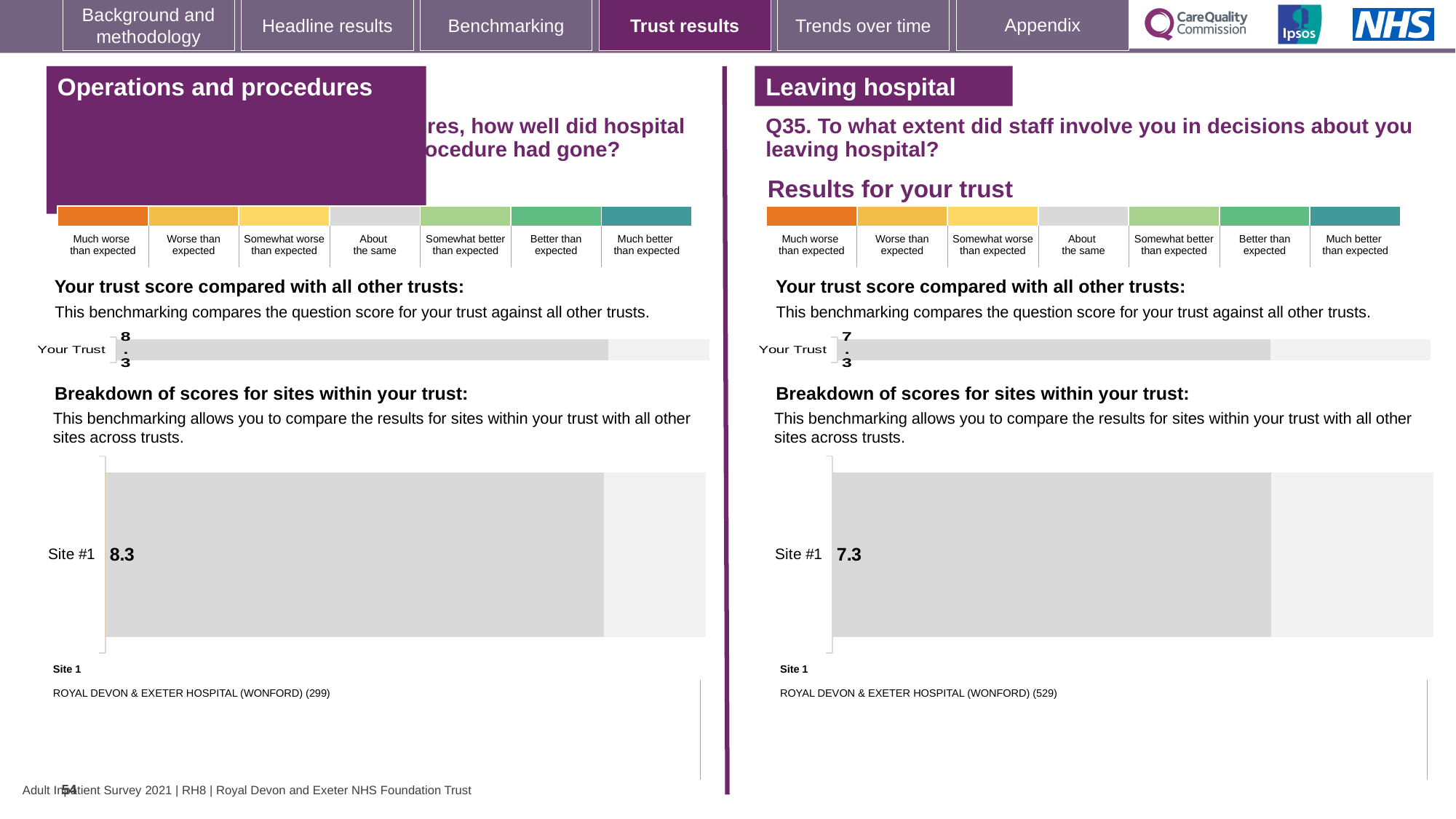
What type of chart is used to show the Your Trust score in the 'Operations and procedures' section? Bar chart What is the difference between the Site #1 score in the 'Operations and procedures' section and the Site #1 score in the 'Leaving hospital' section? 1.0 How many sites are shown in the 'Breakdown of scores for sites within your trust' chart in the 'Leaving hospital' section? 1 How many sites are shown in the 'Breakdown of scores for sites within your trust' chart in the 'Operations and procedures' section? 1 Which site is listed as Site 1 in the 'Leaving hospital' section? ROYAL DEVON & EXETER HOSPITAL (WONFORD) (529) In the 'Leaving hospital' section, what score is shown for Site #1 in the 'Breakdown of scores for sites within your trust' chart? 7.3 Which is larger: the Your Trust score in the 'Operations and procedures' section or the Your Trust score in the 'Leaving hospital' section? Operations and procedures In the 'Operations and procedures' section, what score is shown for Site #1 in the 'Breakdown of scores for sites within your trust' chart? 8.3 In the 'Leaving hospital' section, what is the score shown for Your Trust in the 'Your trust score compared with all other trusts' chart? 7.3 What type of chart is used to show the Site #1 score in the 'Leaving hospital' section? Bar chart Which question is the 'Leaving hospital' section's charts about? Q35. To what extent did staff involve you in decisions about you leaving hospital? In the 'Operations and procedures' section, what is the score shown for Your Trust in the 'Your trust score compared with all other trusts' chart? 8.3